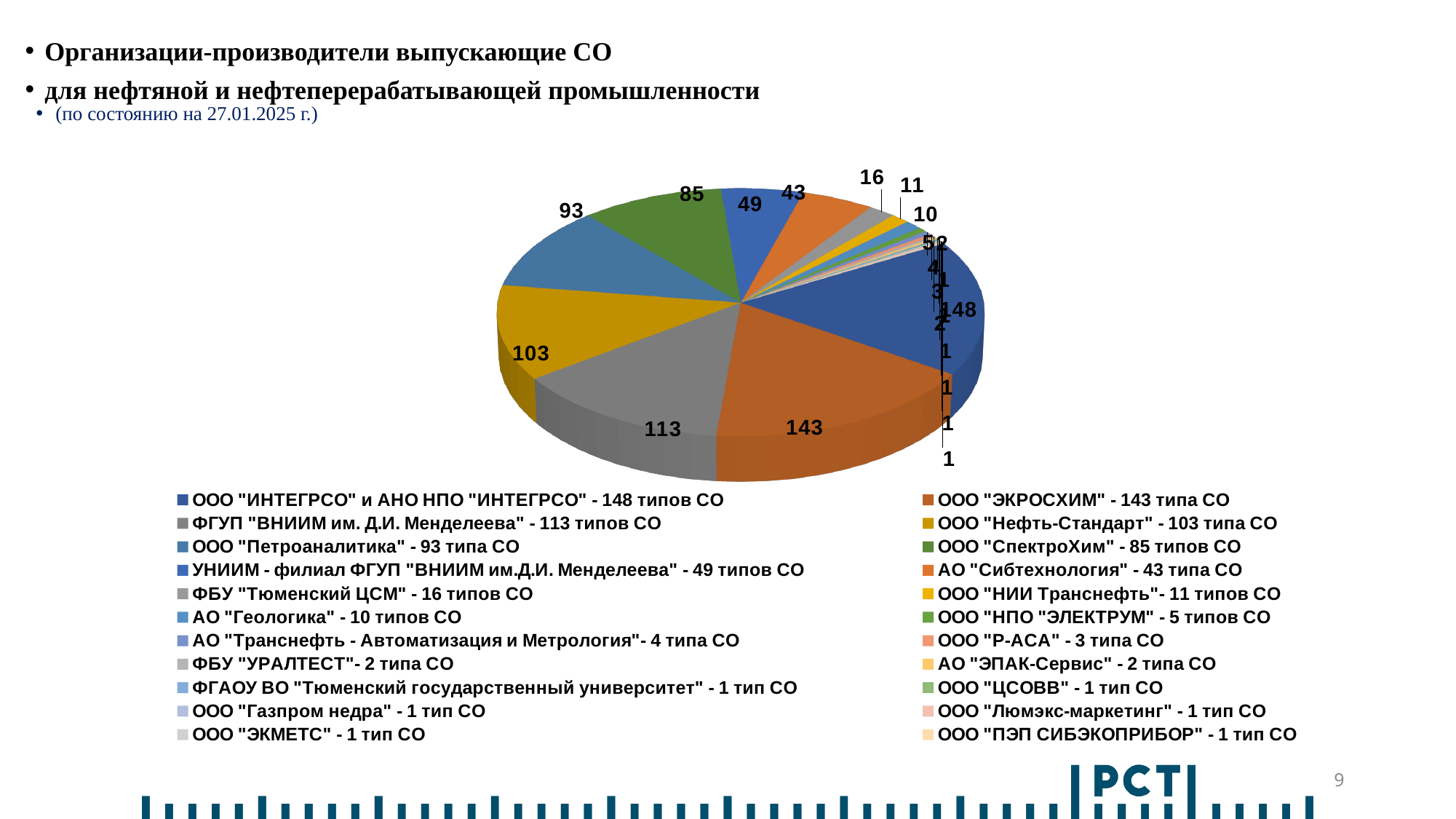
As of what date is the data in the chart given? 27.01.2025 What value is shown for АО "Сибтехнология"? 43 How many organisations are listed in the legend of the chart? 22 What kind of chart is shown on the slide? pie chart What is the smallest value shown in the chart? 1 What is the difference between the values for ФГУП "ВНИИМ им. Д.И. Менделеева" and ООО "СпектроХим"? 28 What value is shown for ООО "Петроаналитика"? 93 What is the difference between the values for ООО "ИНТЕГРСО" и АНО НПО "ИНТЕГРСО" and ООО "ЭКРОСХИМ"? 5 What value is shown for ООО "Нефть-Стандарт"? 103 Which is larger: the value for ООО "Петроаналитика" or the value for ООО "СпектроХим"? ООО "Петроаналитика" Which organisation has the largest slice of the pie? ООО "ИНТЕГРСО" и АНО НПО "ИНТЕГРСО" How many types of CO does ООО "ЭКРОСХИМ" produce according to the chart? 143